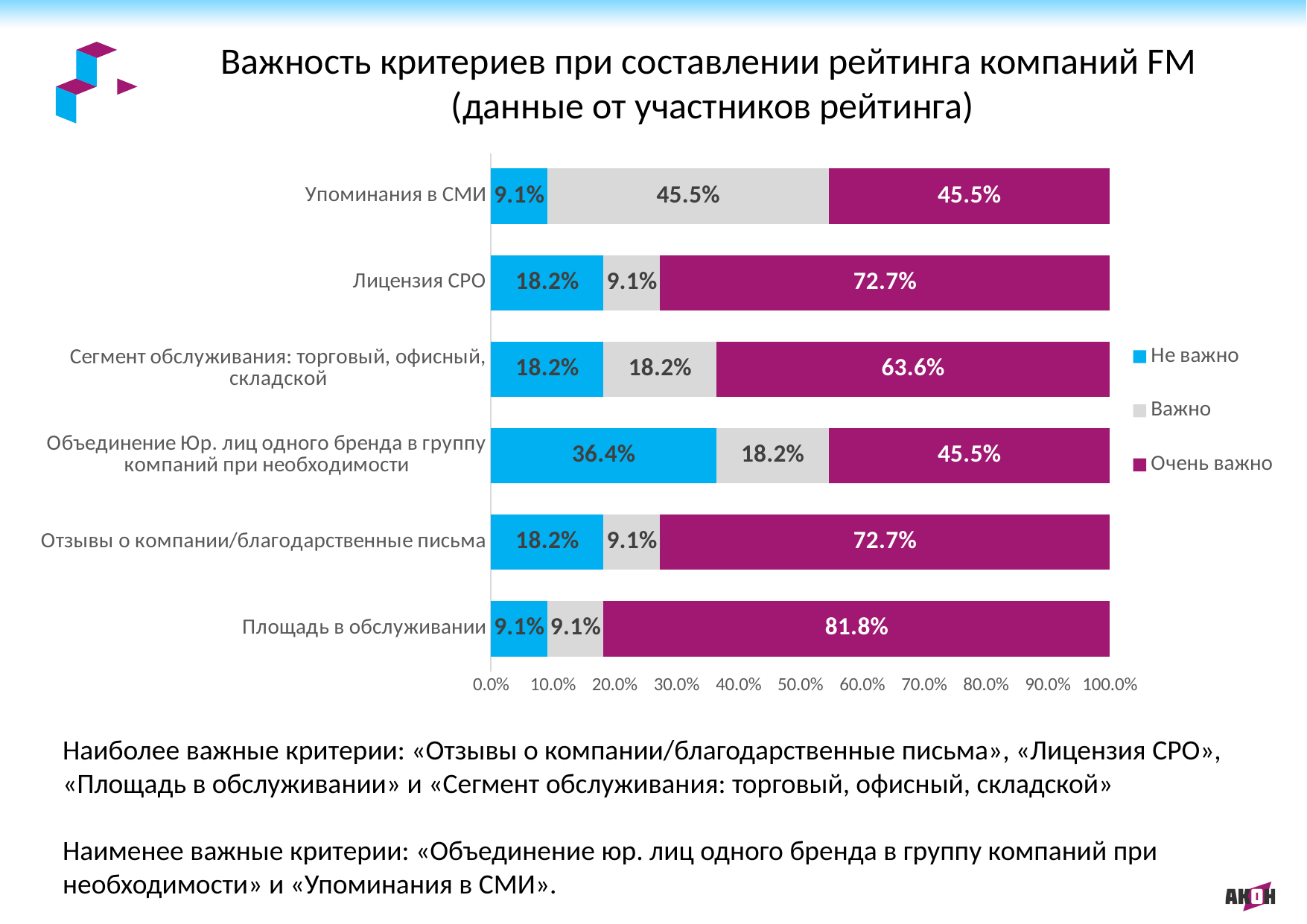
Which is larger: the "Очень важно" value for "Лицензия СРО" or for "Упоминания в СМИ"? Лицензия СРО How many series does the legend list? 3 What is the difference between the "Очень важно" values for "Площадь в обслуживании" and "Лицензия СРО"? 9.1 percentage points Which criterion has the highest "Очень важно" share? Площадь в обслуживании Which legend entry is shown in magenta? Очень важно What is the "Очень важно" value for "Сегмент обслуживания: торговый, офисный, складской"? 63.6% What is the "Не важно" value for "Объединение Юр. лиц одного бренда в группу компаний при необходимости"? 36.4% What kind of chart is shown on the slide? Stacked bar chart Which criterion has the highest "Не важно" share? Объединение Юр. лиц одного бренда в группу компаний при необходимости What is the "Очень важно" value for "Площадь в обслуживании"? 81.8% What is the "Важно" value for "Упоминания в СМИ"? 45.5% How many criteria (categories) are plotted in the chart? 6